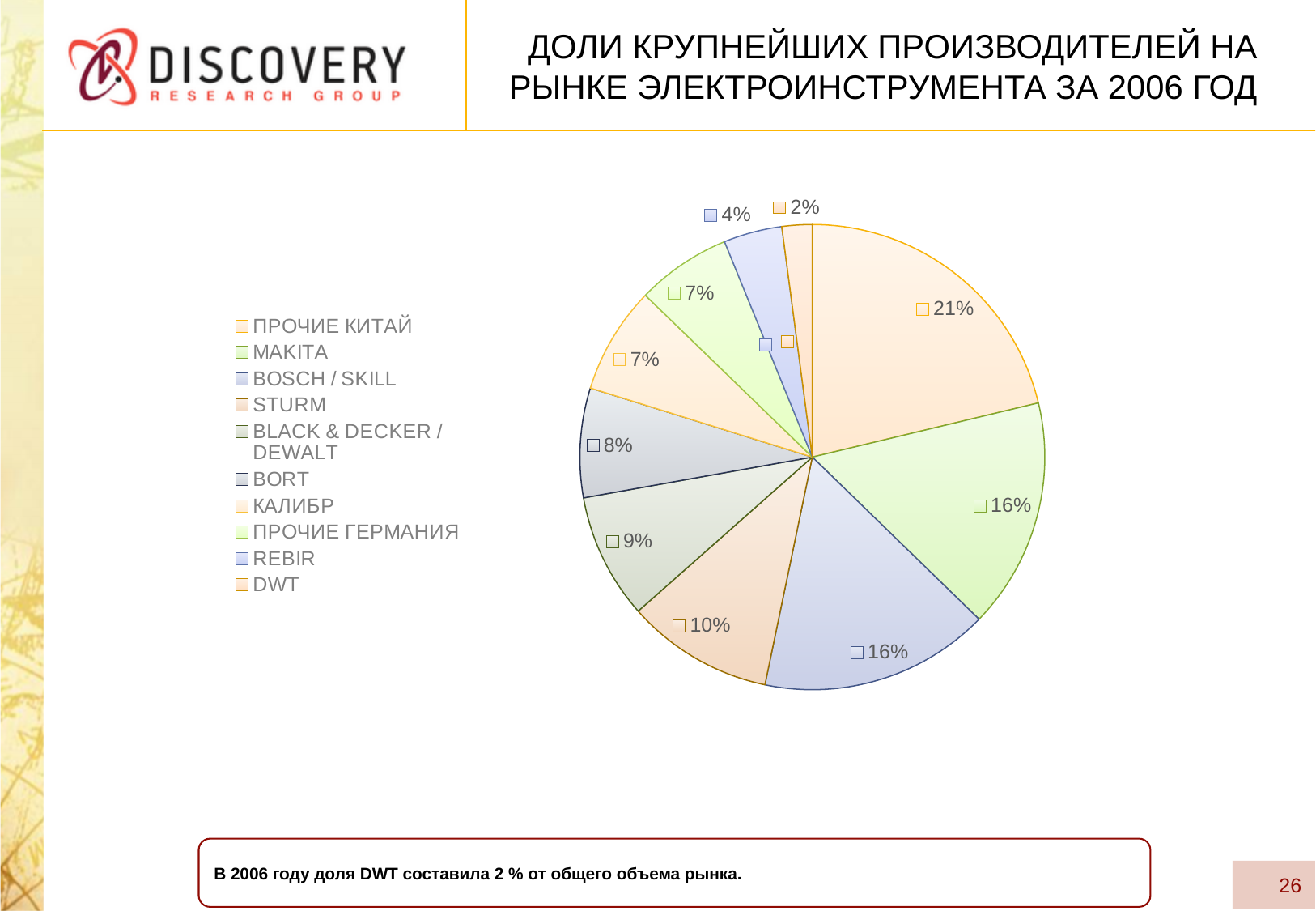
What is the difference in percentage points between the share of ПРОЧИЕ КИТАЙ and the share of DWT? 19 What share of the market does MAKITA hold in the pie chart? 16% What share of the market does REBIR hold in the pie chart? 4% How many categories does the legend of the pie chart list? 10 Which has the larger share in the pie chart, STURM or BORT? STURM What share of the market does ПРОЧИЕ КИТАЙ hold in the pie chart? 21% Which category has the largest slice of the pie chart? ПРОЧИЕ КИТАЙ What is the combined share of MAKITA and BOSCH / SKILL in the pie chart? 32% What kind of chart is shown on the slide? pie chart Which category has the smallest slice of the pie chart? DWT What share of the market does STURM hold in the pie chart? 10% What share of the market does DWT hold in the pie chart? 2%